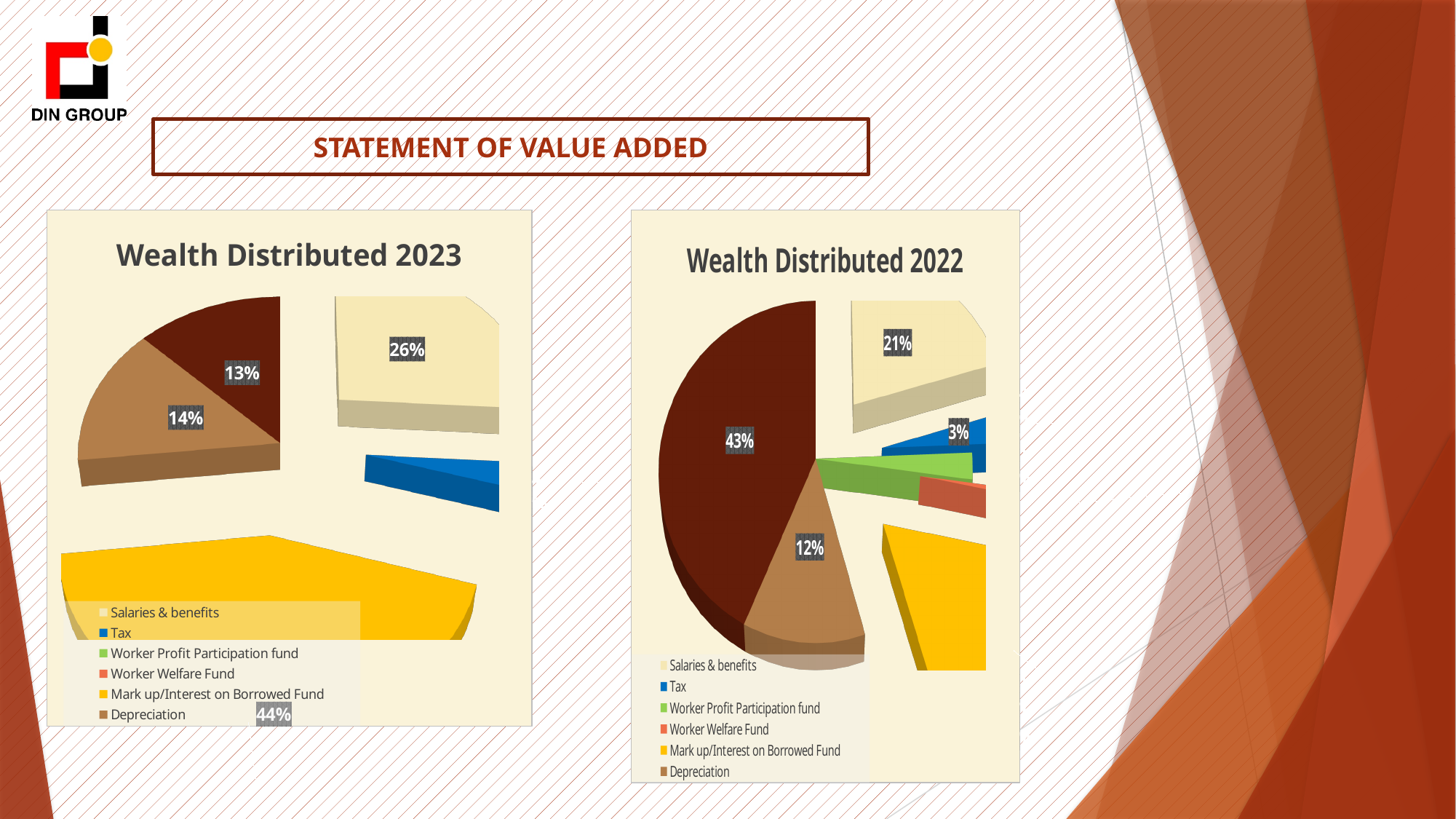
In the "Wealth Distributed 2023" chart, what percentage is shown for Depreciation? 14% In the "Wealth Distributed 2022" chart, what percentage is shown for Salaries & benefits? 21% In the "Wealth Distributed 2023" chart, which is larger: Salaries & benefits or Depreciation? Salaries & benefits In the "Wealth Distributed 2022" chart, what percentage is shown for Depreciation? 12% In the "Wealth Distributed 2023" chart, which legend category has the largest share? Mark up/Interest on Borrowed Fund By how many percentage points does Salaries & benefits in the "Wealth Distributed 2023" chart exceed Salaries & benefits in the "Wealth Distributed 2022" chart? 5 percentage points How many categories does the legend of the "Wealth Distributed 2022" chart list? 6 What kind of chart is "Wealth Distributed 2023"? Pie chart In the "Wealth Distributed 2023" chart, what percentage is shown for Mark up/Interest on Borrowed Fund? 44% In the "Wealth Distributed 2023" chart, what percentage is shown for Salaries & benefits? 26% In the "Wealth Distributed 2022" chart, what is the largest percentage label shown? 43%